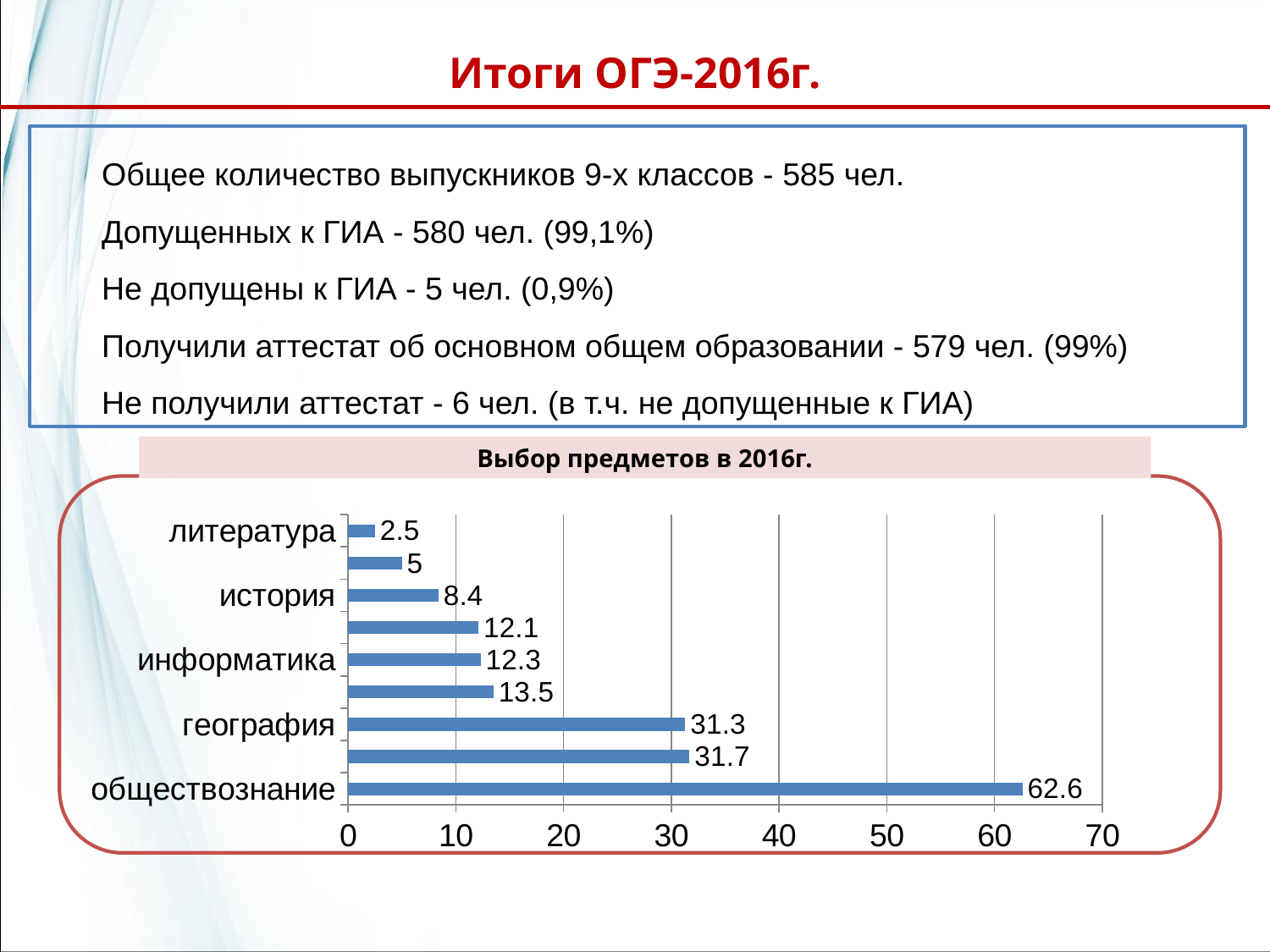
How many bars are plotted in the chart? 9 What is the value for литература? 2.5 What is the difference between the values for обществознание and география? 31.3 Which category has the lowest value? литература What is the value for история? 8.4 What is the value for обществознание? 62.6 What is the value for информатика? 12.3 What is the title of the chart? Выбор предметов в 2016г. Which category has the highest value? обществознание Which is larger, the value for информатика or the value for история? информатика What is the value for география? 31.3 What kind of chart is shown under the heading "Выбор предметов в 2016г."? bar chart